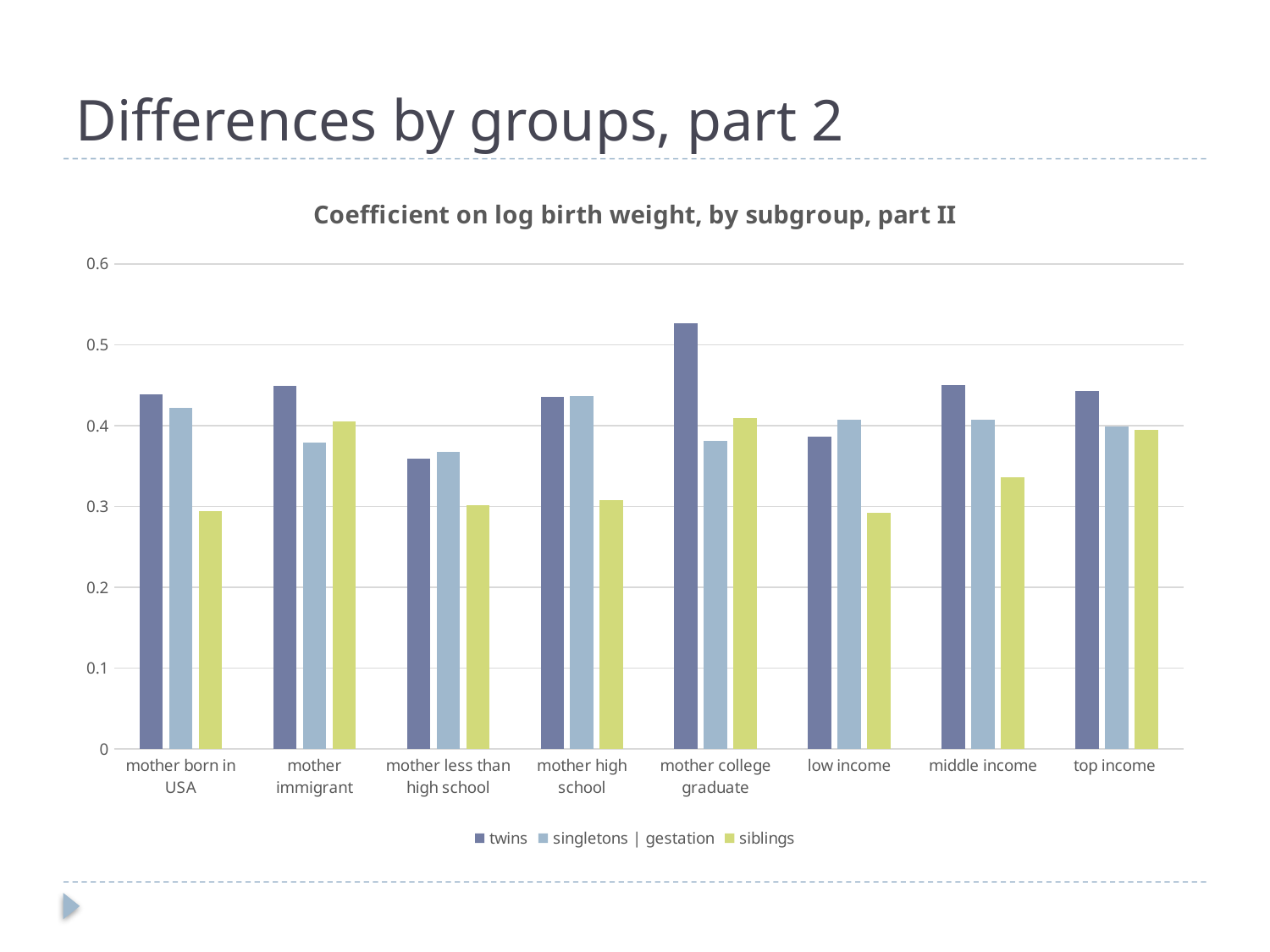
For mother college graduate, which is larger: the twins value or the siblings value? twins What kind of chart is shown on the slide? bar chart Is the siblings value for mother high school greater or less than 0.4? less Which subgroup has the highest value for the twins series? mother college graduate Is the twins value for mother college graduate greater or less than 0.5? greater How many subgroup categories are shown on the x axis? 8 What is the title of the chart? Coefficient on log birth weight, by subgroup, part II Is the twins value for low income greater or less than 0.4? less Which subgroup has the lowest value for the twins series? mother less than high school For low income, which is larger: the twins value or the singletons | gestation value? singletons | gestation How many series does the legend list? 3